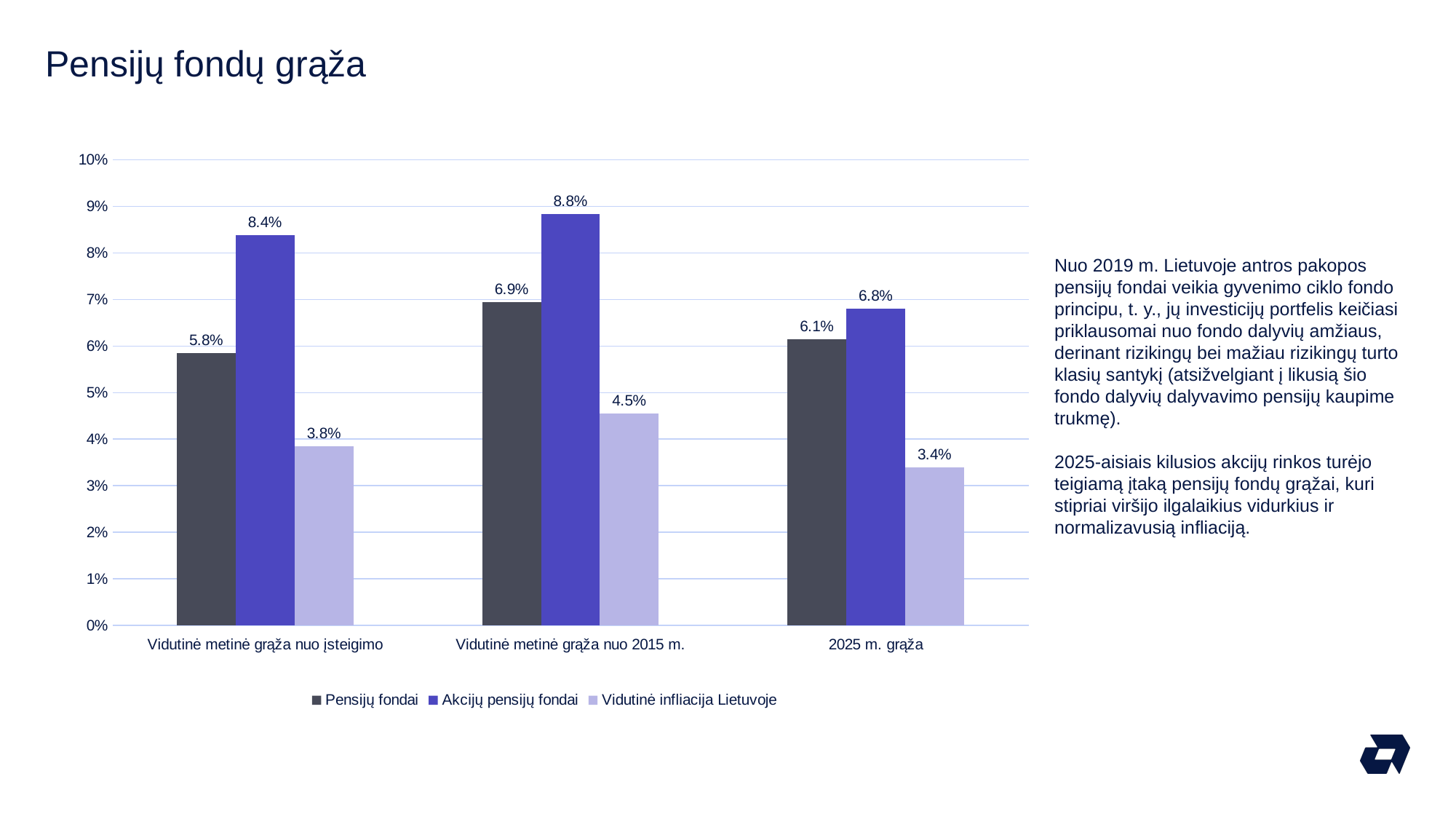
Is the value for Pensijų fondai in the 'Vidutinė metinė grąža nuo 2015 m.' category greater or less than 6%? greater What is the value for Vidutinė infliacija Lietuvoje in the '2025 m. grąža' category? 3.4% In which category is the Akcijų pensijų fondai value highest? Vidutinė metinė grąža nuo 2015 m. What kind of chart is shown on the slide? Bar chart In which category is the Vidutinė infliacija Lietuvoje value lowest? 2025 m. grąža What is the title of the slide? Pensijų fondų grąža What is the value for Pensijų fondai in the 'Vidutinė metinė grąža nuo įsteigimo' category? 5.8% How many categories are shown on the x axis? 3 How many series does the legend list? 3 Which is larger in the '2025 m. grąža' category: Pensijų fondai or Akcijų pensijų fondai? Akcijų pensijų fondai What is the difference between Akcijų pensijų fondai and Pensijų fondai in the 'Vidutinė metinė grąža nuo įsteigimo' category? 2.6% What is the value for Akcijų pensijų fondai in the 'Vidutinė metinė grąža nuo 2015 m.' category? 8.8%